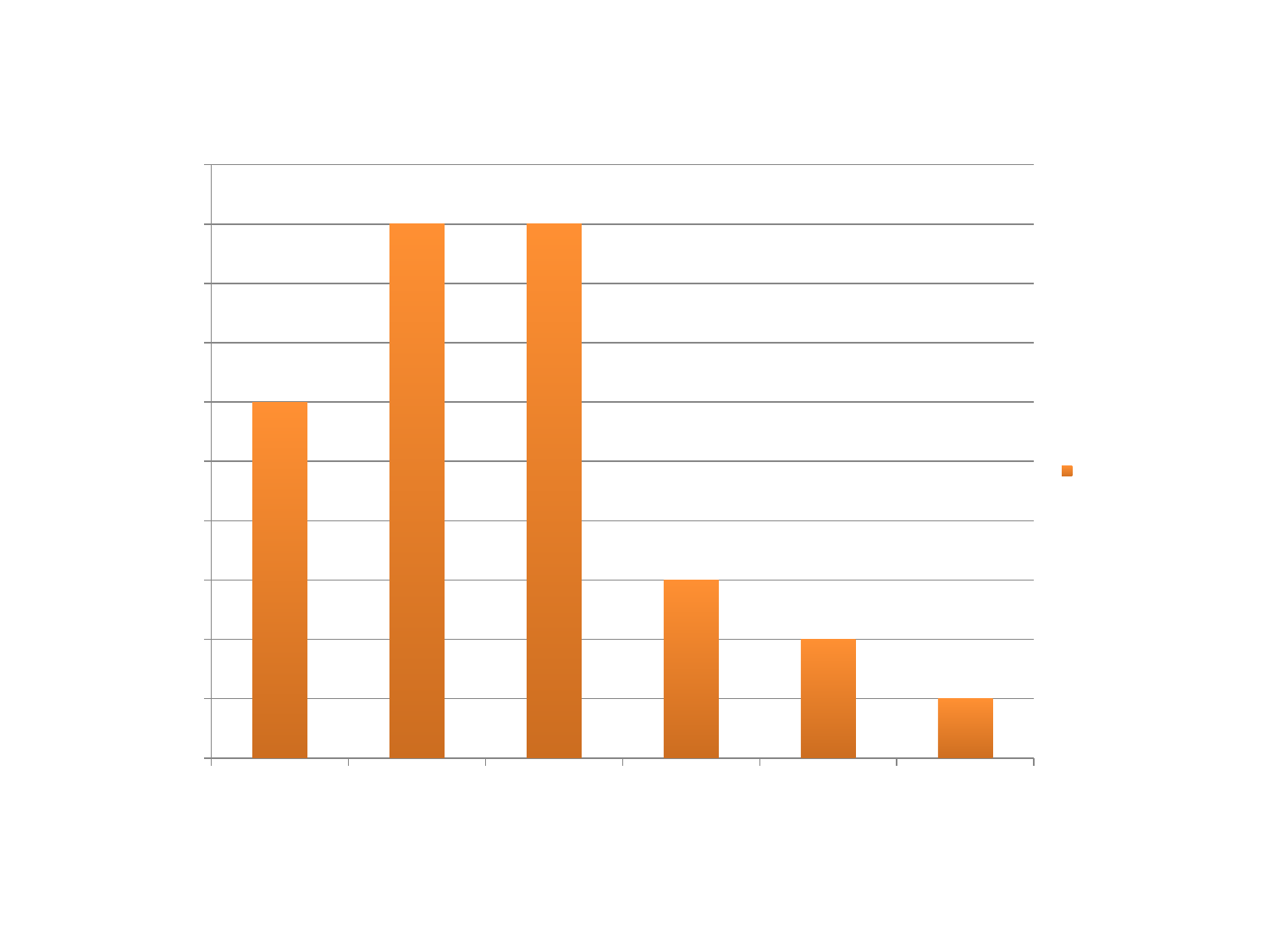
What kind of chart is shown on the slide? bar chart How many series does the legend list? 1 Which bar is the lowest: the first (leftmost) or the sixth (rightmost)? the sixth (rightmost) How many bars does the chart have? 6 Do the bar heights rise or fall from the fourth bar to the sixth bar? fall Which is taller, the second bar or the fifth bar? the second bar What colour are the bars in the chart? orange Which is taller, the first bar or the fourth bar? the first bar